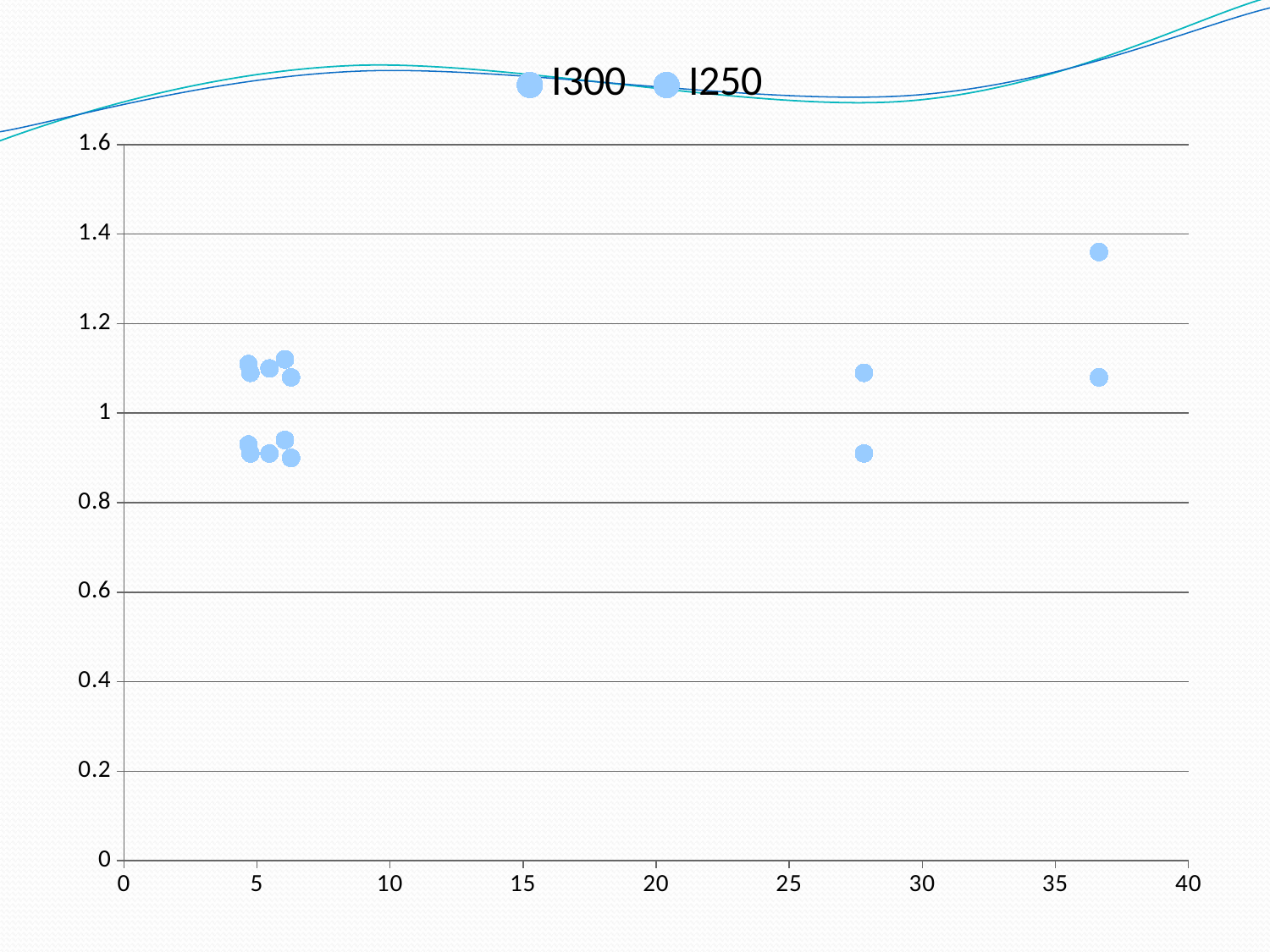
Are the lower cluster of points near x = 5 greater or less than 0.8? greater Is the highest plotted point (near x = 37) greater or less than 1.2? greater Is the upper point near x = 28 greater or less than 1? greater What kind of chart is shown on the slide? scatter chart What are the two series names shown in the legend? I300 and I250 Which is larger: the upper point near x = 37 or the upper point near x = 28? the upper point near x = 37 What is the maximum value shown on the vertical axis? 1.6 How many series does the legend list? 2